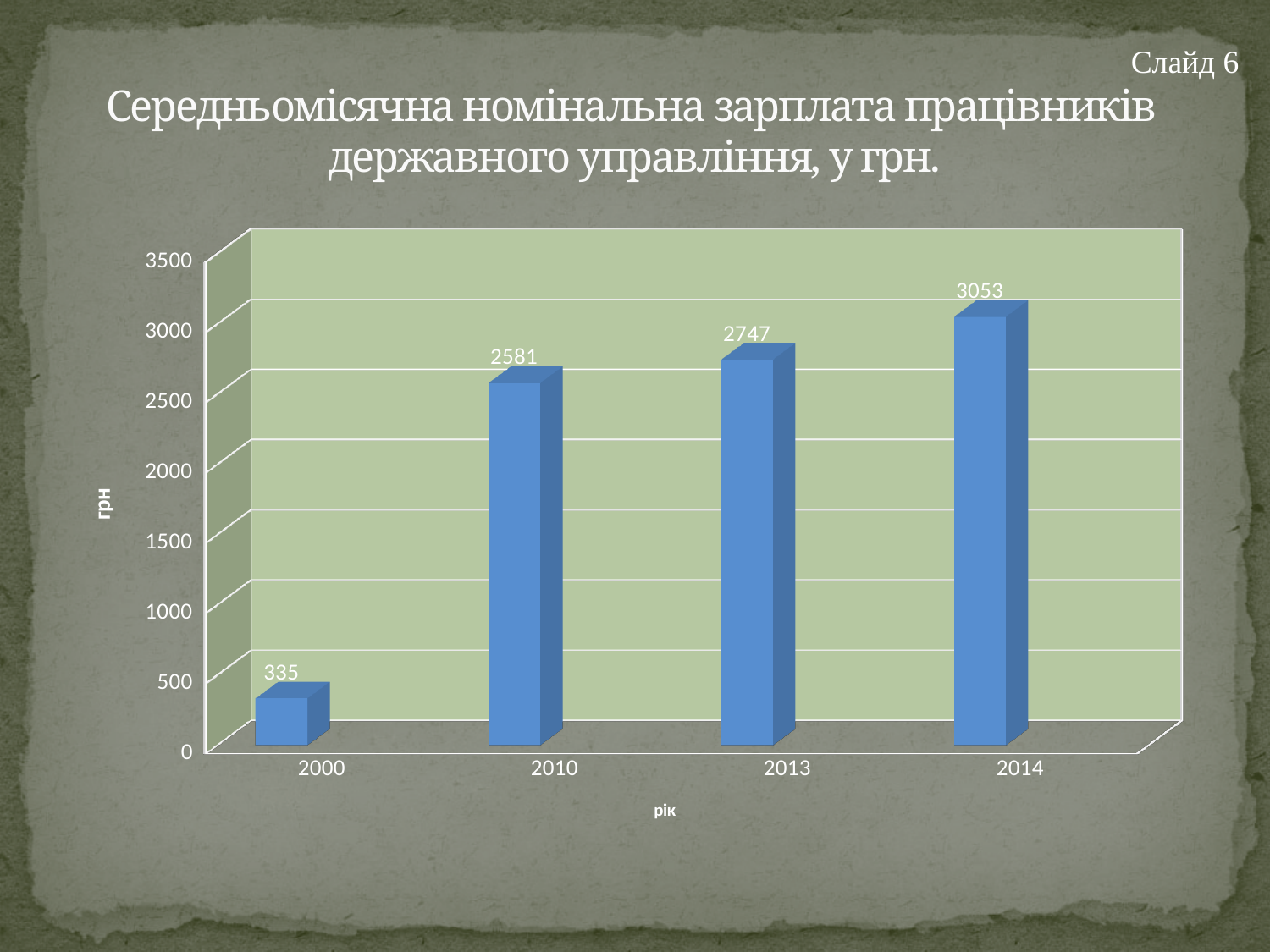
Which year has the lowest value? 2000 Which year has the highest value? 2014 What is the difference between the values for 2010 and 2000? 2246 What is the difference between the values for 2014 and 2013? 306 How many years are shown on the x axis? 4 What is the value for 2000? 335 Do the values rise or fall from 2000 to 2014? rise What is the value for 2013? 2747 What kind of chart is this? bar chart What is the value for 2014? 3053 Which is larger, the value for 2010 or the value for 2013? 2013 What is the value for 2010? 2581